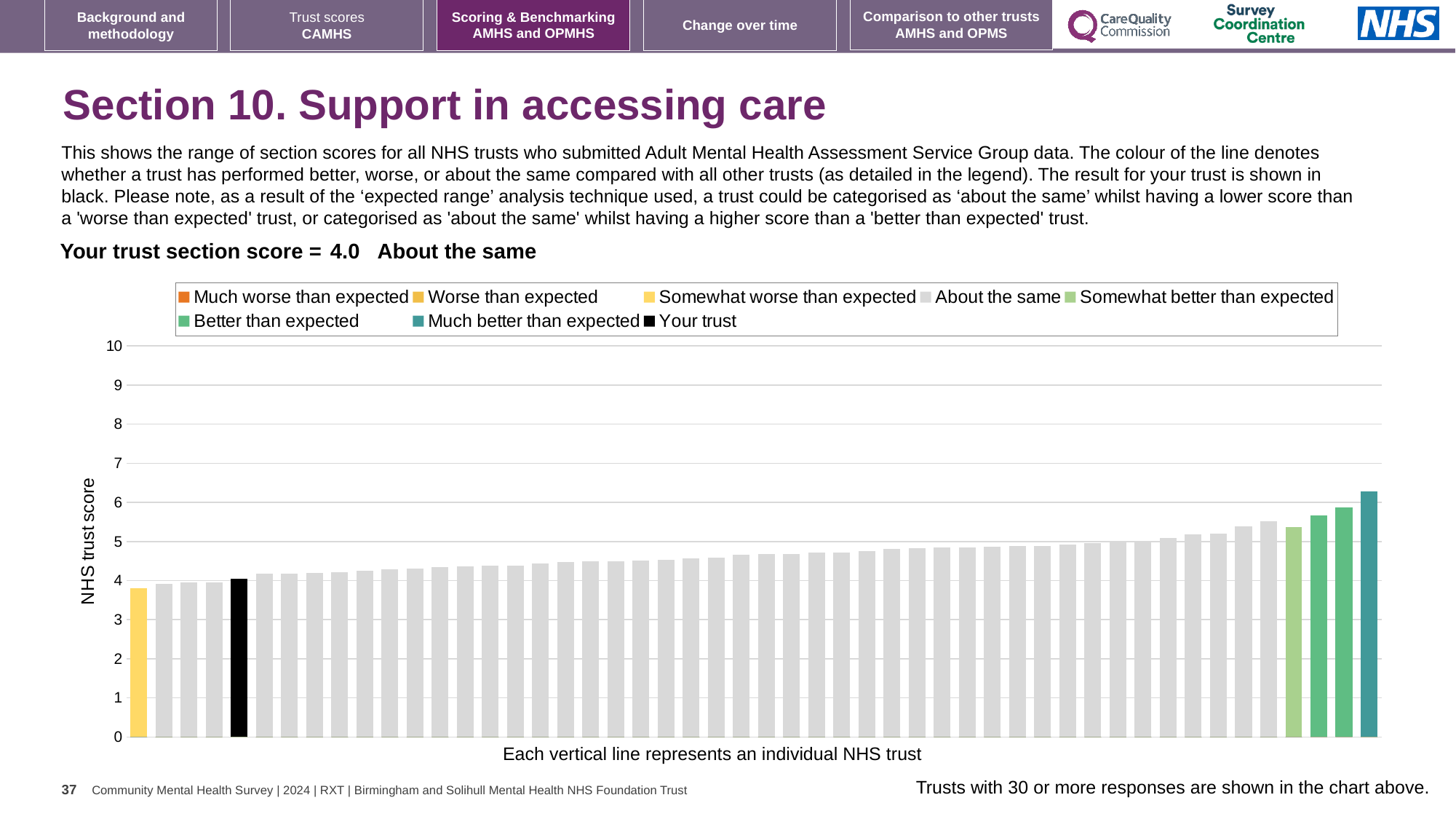
Is the value of the black 'Your trust' bar greater or less than 5? less What is the section score for your trust shown on the slide? 4.0 What colour is the bar representing your trust? black Is the value of the tallest bar in the chart greater or less than 6? greater What is the label on the vertical axis of the chart? NHS trust score Is the value of the tallest bar in the chart greater or less than 7? less How many entries does the chart legend list? 8 How many bars are coloured as 'Much better than expected' (teal)? 1 Which is larger, the rightmost bar or the black 'Your trust' bar? the rightmost bar Do the bar values rise or fall from left to right along the x axis? rise What kind of chart is shown on the slide? bar chart